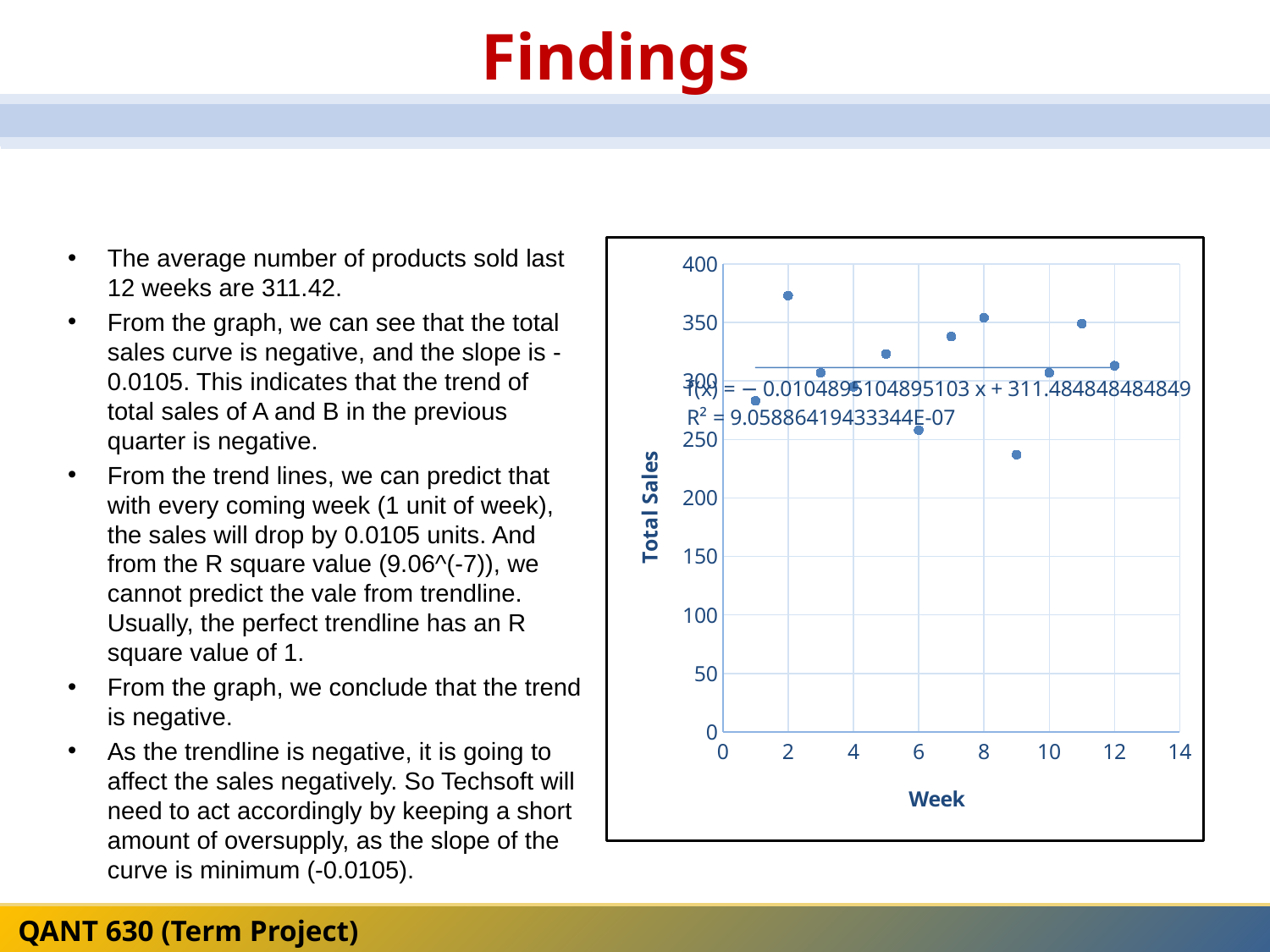
Is the Total Sales value for week 5 greater or less than 300? greater What is the title of the horizontal axis of the chart? Week What R² value is displayed on the chart? 9.05886419433344E-07 Is the Total Sales value for week 2 greater or less than 350? greater Is the Total Sales value for week 9 greater or less than 250? less Which week has the lowest Total Sales value on the chart? Week 9 Which week has the highest Total Sales value on the chart? Week 2 What kind of chart is shown on the slide? scatter chart How many data points are plotted on the chart? 12 Which has the larger Total Sales value, week 4 or week 11? Week 11 Which has the larger Total Sales value, week 8 or week 6? Week 8